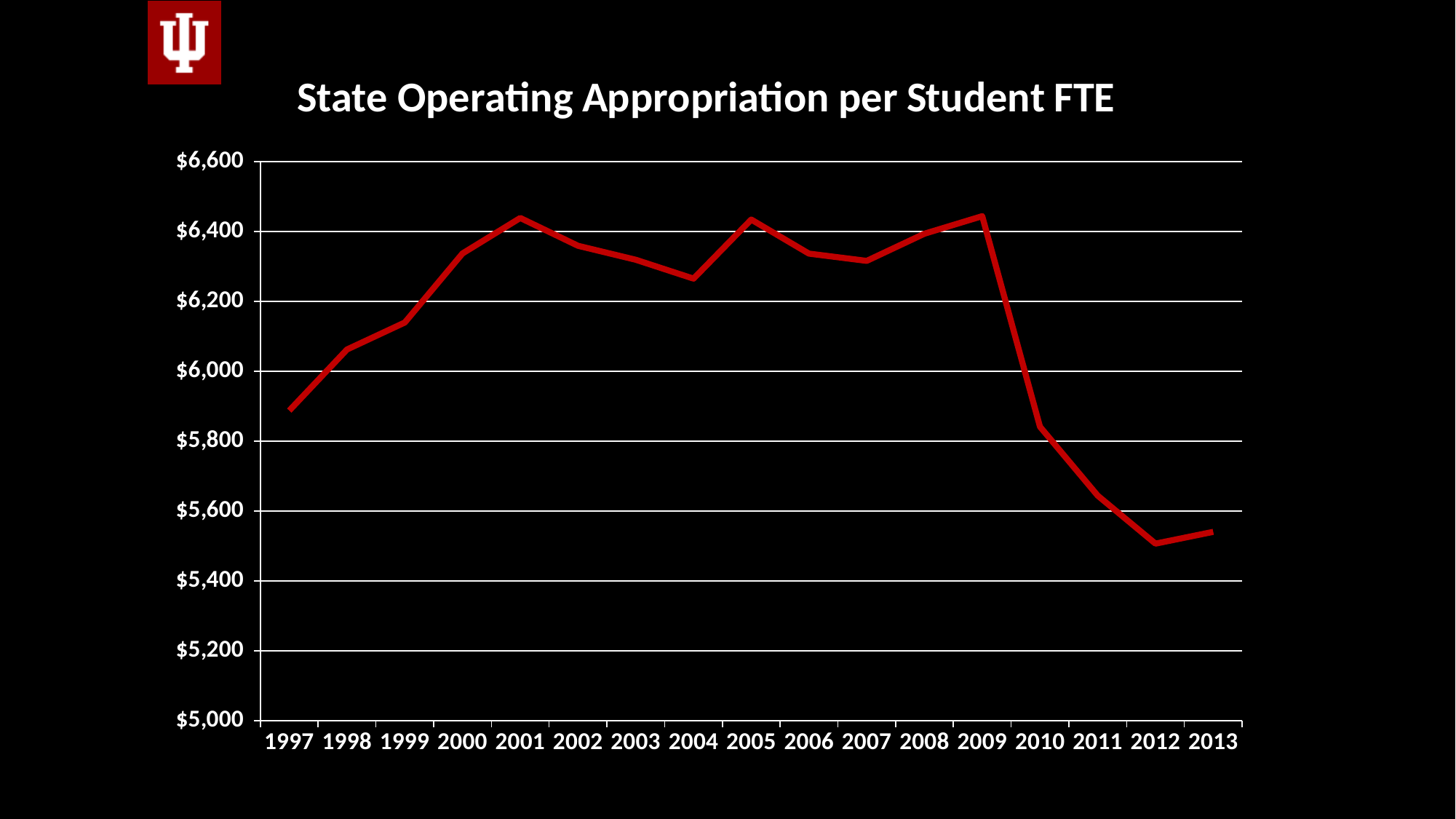
Which year has the lowest state operating appropriation per student FTE? 2012 How many years are plotted along the x axis? 17 Which year has the larger value, 2009 or 2010? 2009 Is the value for 2010 greater or less than $6,000? less Which year has the larger value, 1997 or 2013? 1997 What kind of chart is shown on the slide? line chart Is the value for 2001 greater or less than $6,400? greater Do the values rise or fall from 2009 to 2012? fall Is the value for 1997 greater or less than $6,000? less What is the title of the chart? State Operating Appropriation per Student FTE